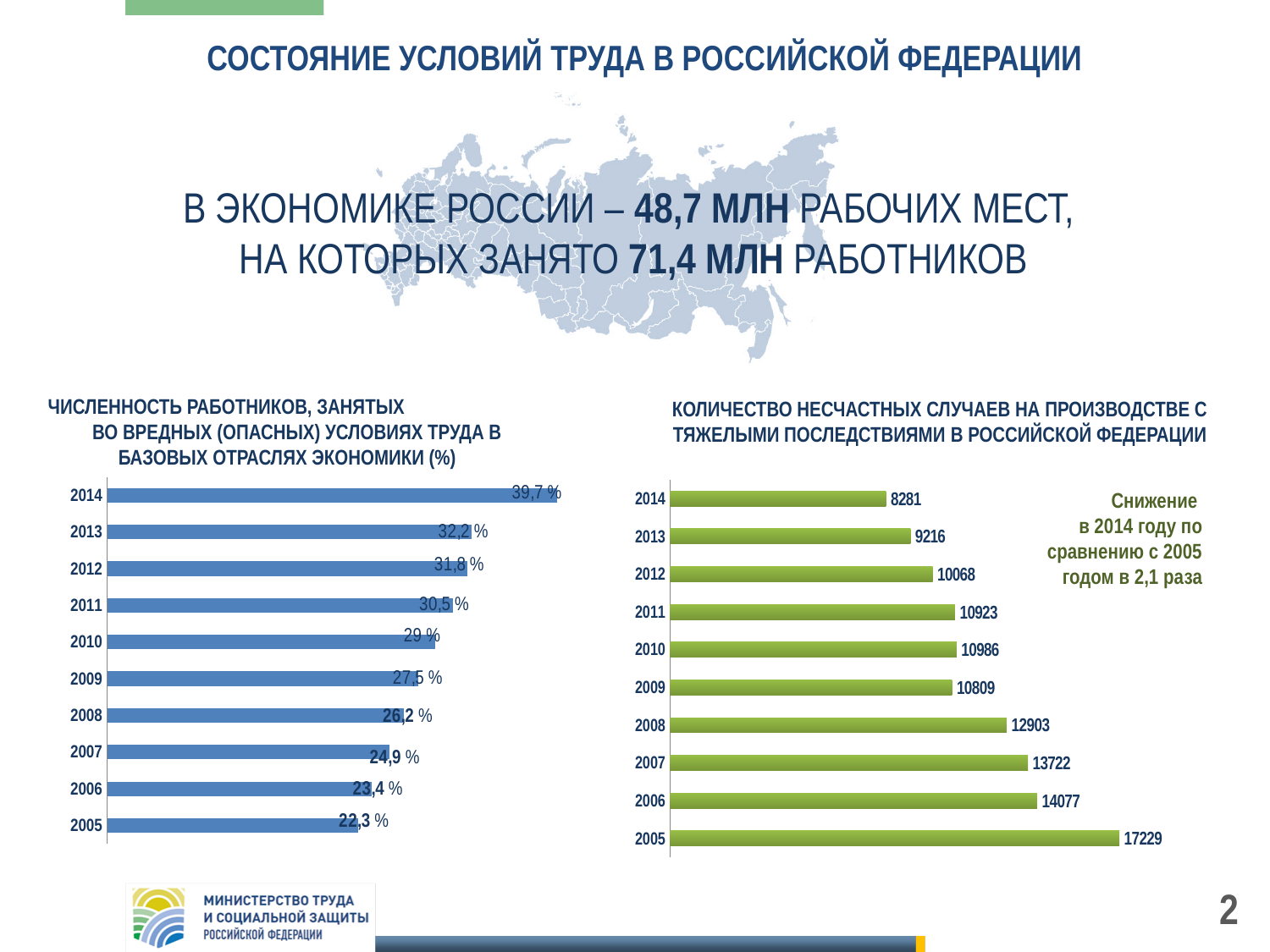
How many years are shown in the left chart? 10 In the left chart, what is the difference between the values for 2014 and 2013? 7,5 % In the left chart, which year has the highest value? 2014 In the right chart, what is the value for 2005? 17229 What kind of chart is the right chart? bar chart In the right chart, what is the value for 2014? 8281 In the right chart, which year has the highest value? 2005 In the left chart, what is the value for 2014? 39,7 % In the right chart, what is the difference between the values for 2005 and 2014? 8948 In the left chart, what is the value for 2005? 22,3 % In the right chart, which year has the lowest value? 2014 In the right chart, which is larger, the value for 2010 or the value for 2009? 2010